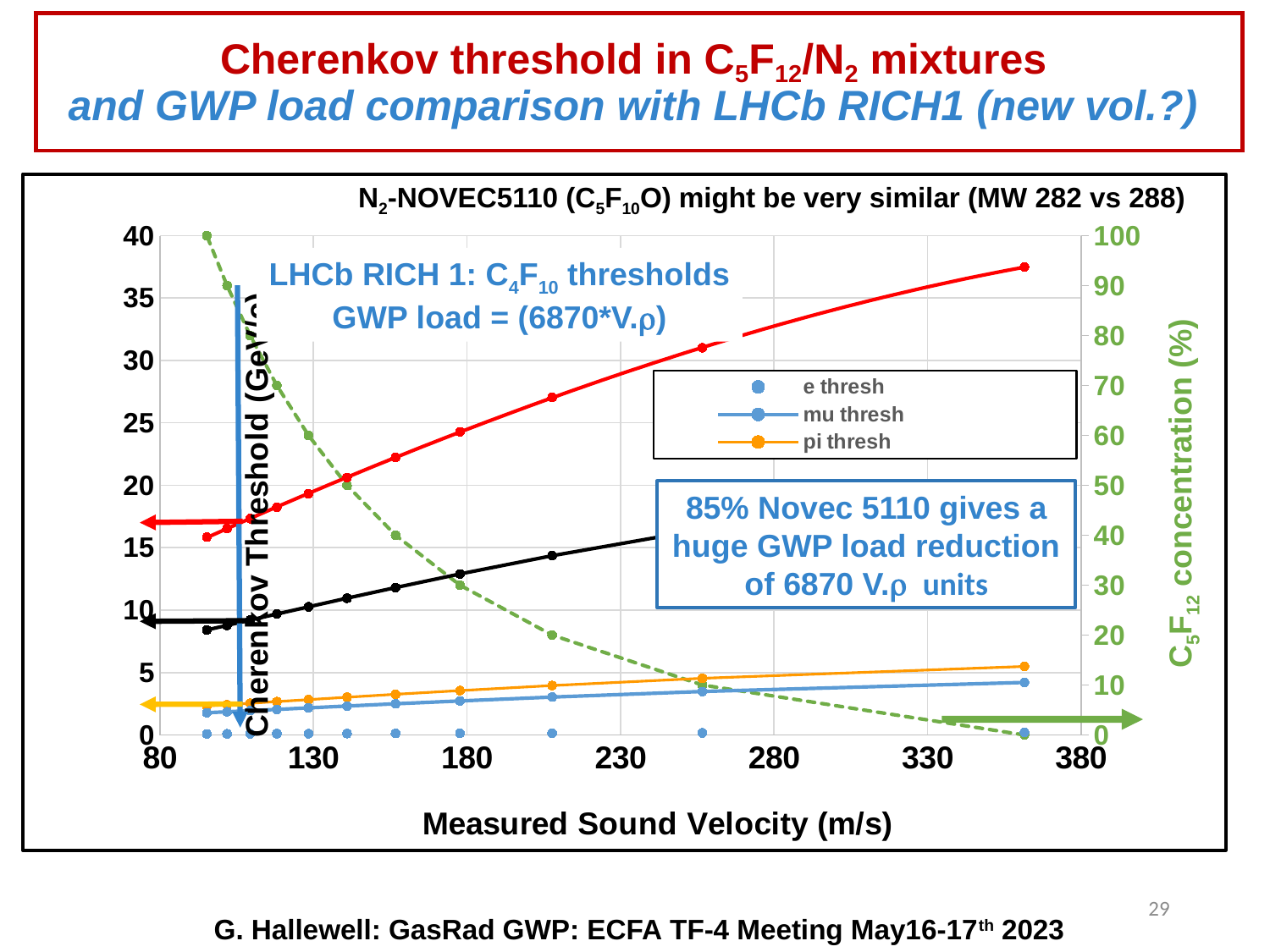
Is the value of the black line at about 180 m/s greater or less than 15 on the left axis? less How many series does the legend list? 3 Is the value of the red line at about 205 m/s greater or less than 25 on the left axis? greater What is the title of the x axis? Measured Sound Velocity (m/s) What are the three series named in the legend? e thresh, mu thresh, pi thresh Is the value of the red line at its rightmost point (around 360 m/s) greater or less than 35 on the left axis? greater Does the green dashed line (C5F12 concentration) rise or fall as the measured sound velocity increases? fall What kind of chart is shown on the slide? line chart Does the red line rise or fall as the measured sound velocity increases? rise At the rightmost point (around 360 m/s), which is larger: the red line or the mu thresh series? the red line